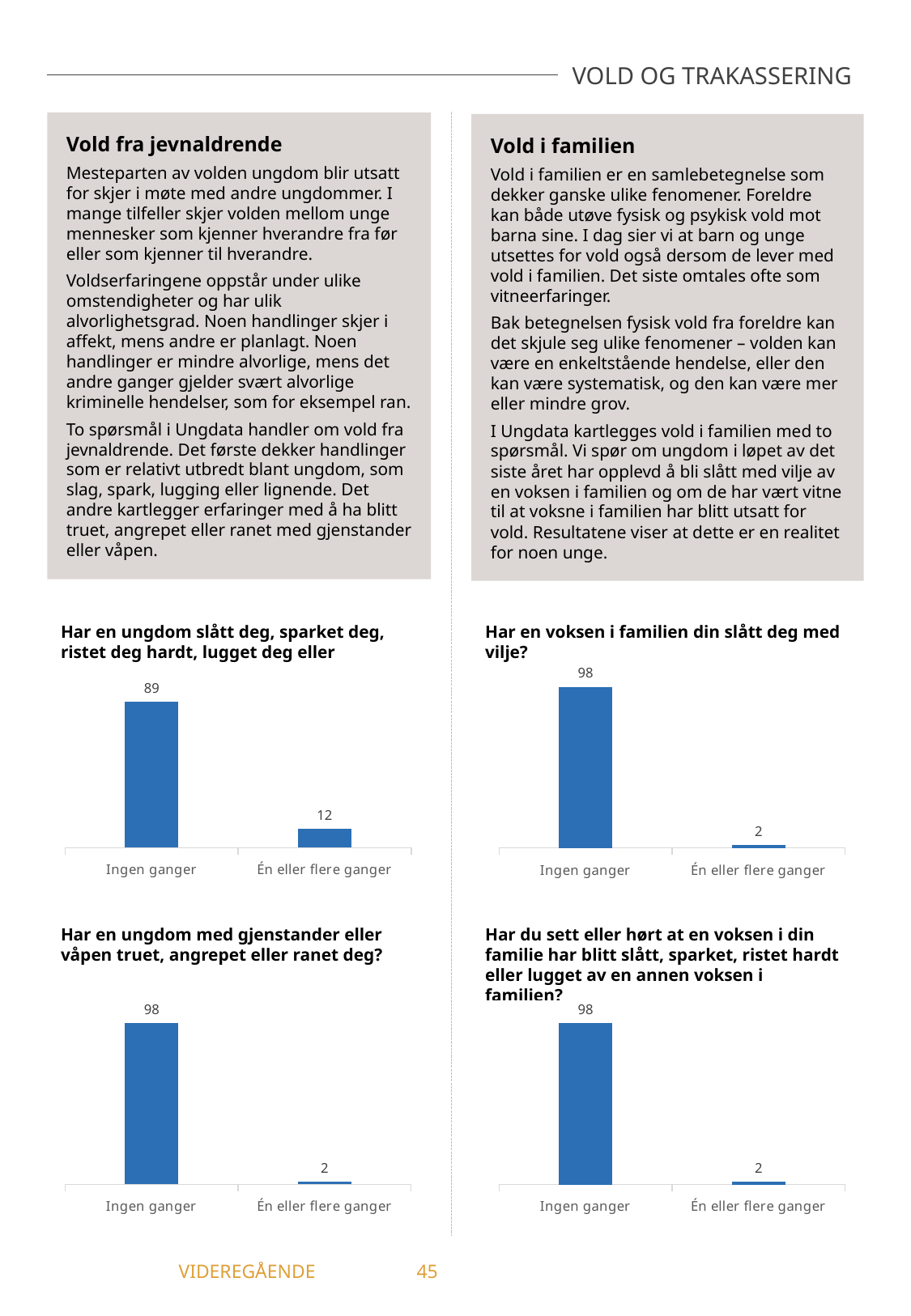
In the bottom-right chart ("Har du sett eller hørt at en voksen i din familie har blitt slått..."), what is the value for "Ingen ganger"? 98 In the chart titled "Har en voksen i familien din slått deg med vilje?", what is the value for "Én eller flere ganger"? 2 In the chart titled "Har en ungdom med gjenstander eller våpen truet, angrepet eller ranet deg?", which category has the highest value? Ingen ganger In the top-left chart ("Har en ungdom slått deg, sparket deg, ristet deg hardt, lugget deg eller"), what is the value for "Ingen ganger"? 89 In the bottom-right chart ("Har du sett eller hørt at en voksen i din familie har blitt slått..."), which category has the lowest value? Én eller flere ganger In the chart titled "Har en ungdom med gjenstander eller våpen truet, angrepet eller ranet deg?", what is the value for "Én eller flere ganger"? 2 In the top-left chart ("Har en ungdom slått deg, sparket deg, ristet deg hardt, lugget deg eller"), what is the value for "Én eller flere ganger"? 12 What type of chart is the top-left chart ("Har en ungdom slått deg, sparket deg, ristet deg hardt, lugget deg eller")? Bar chart In the top-left chart ("Har en ungdom slått deg, sparket deg, ristet deg hardt, lugget deg eller"), what is the difference between the values for "Ingen ganger" and "Én eller flere ganger"? 77 How many charts are shown on the slide? 4 In the chart titled "Har en voksen i familien din slått deg med vilje?", what is the value for "Ingen ganger"? 98 How many categories are shown in the chart titled "Har en voksen i familien din slått deg med vilje?"? 2